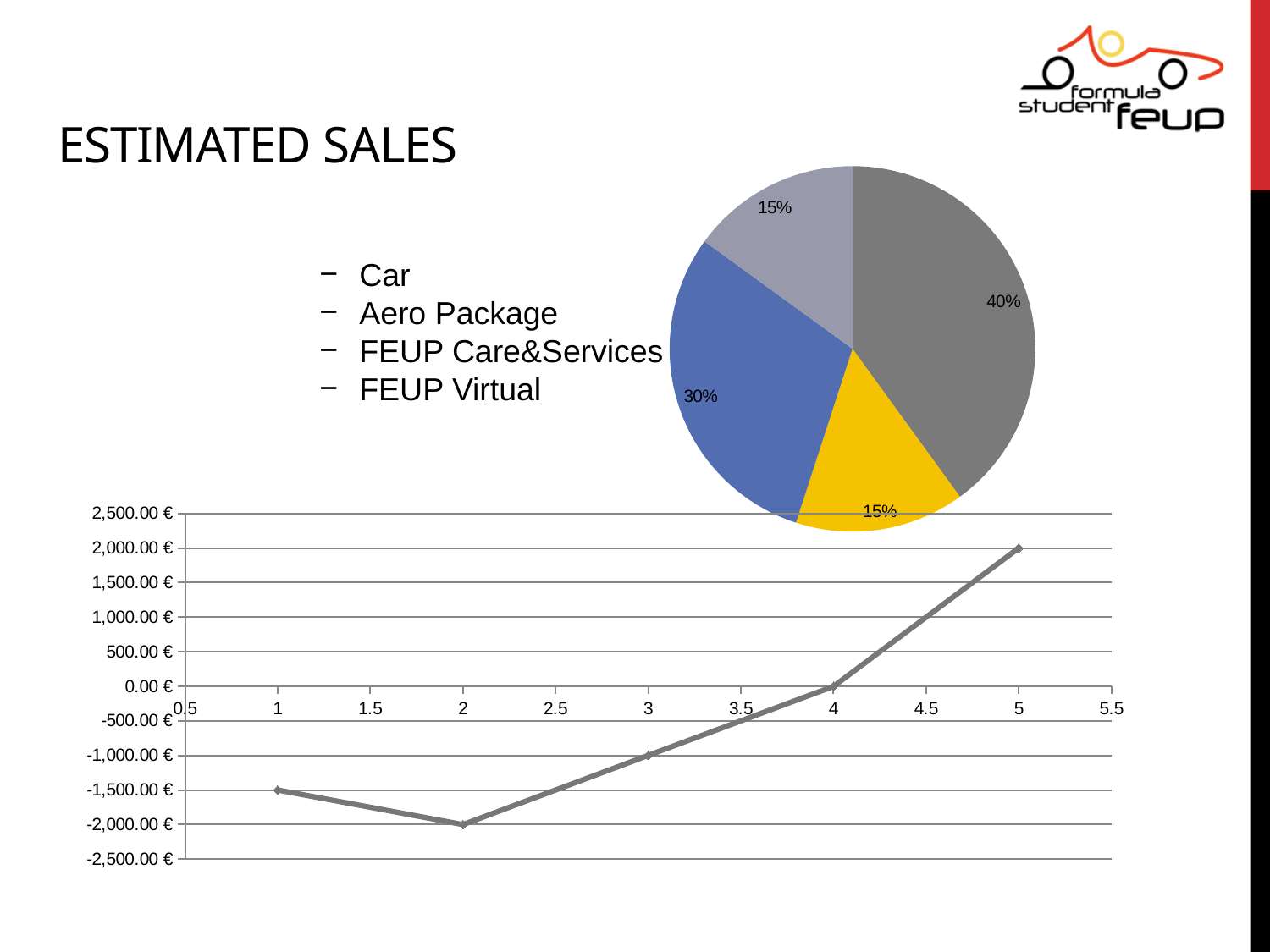
In the line chart at the bottom, what is the value at x = 5? 2,000.00 € What kind of chart is the chart in the top right of the slide? pie chart In the line chart at the bottom, what is the value at x = 2? -2,000.00 € In the line chart at the bottom, what is the difference between the value at x = 5 and the value at x = 2? 4,000.00 € In the pie chart, what is the share of the largest slice? 40% In the line chart at the bottom, at which x value is the plotted value highest? 5 In the pie chart, how many slices are there? 4 In the pie chart, what is the share of the blue slice? 30% In the line chart at the bottom, at which x value is the plotted value lowest? 2 What kind of chart is the chart at the bottom of the slide? line chart In the pie chart, what is the share of the yellow slice? 15% In the line chart at the bottom, how many data points are plotted? 5